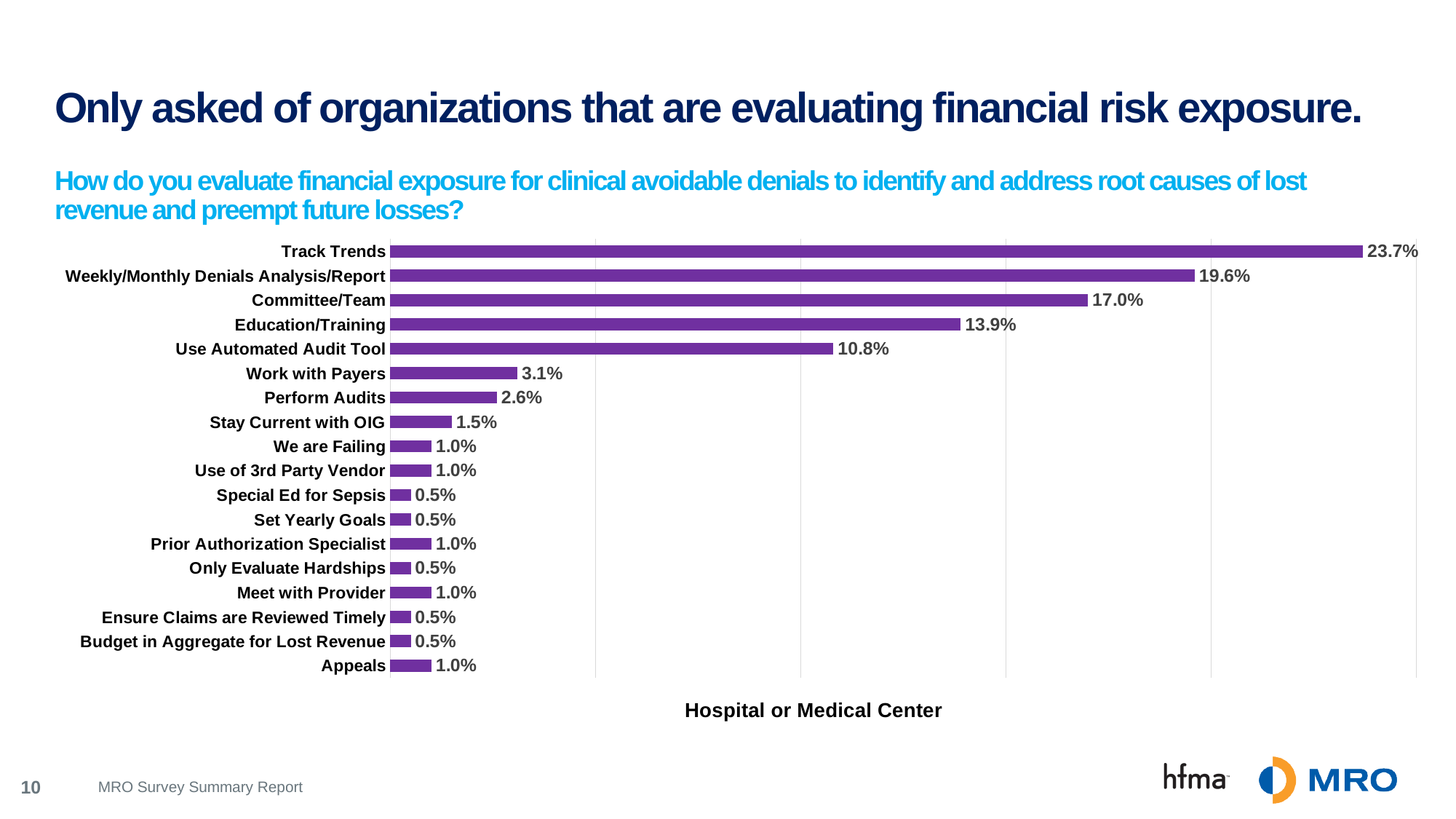
What percentage is shown for Track Trends? 23.7% What kind of chart is shown on the slide? Bar chart Which category has the highest value? Track Trends How many categories are shown in the chart? 18 What is the difference between Weekly/Monthly Denials Analysis/Report and Education/Training? 5.7% What is the value for Use Automated Audit Tool? 10.8% Which is larger, Committee/Team or Use Automated Audit Tool? Committee/Team Which is larger, Stay Current with OIG or Special Ed for Sepsis? Stay Current with OIG What is the value for Committee/Team? 17.0% What percentage is shown for Stay Current with OIG? 1.5% What is the difference between Work with Payers and Perform Audits? 0.5% What is the label shown beneath the chart? Hospital or Medical Center